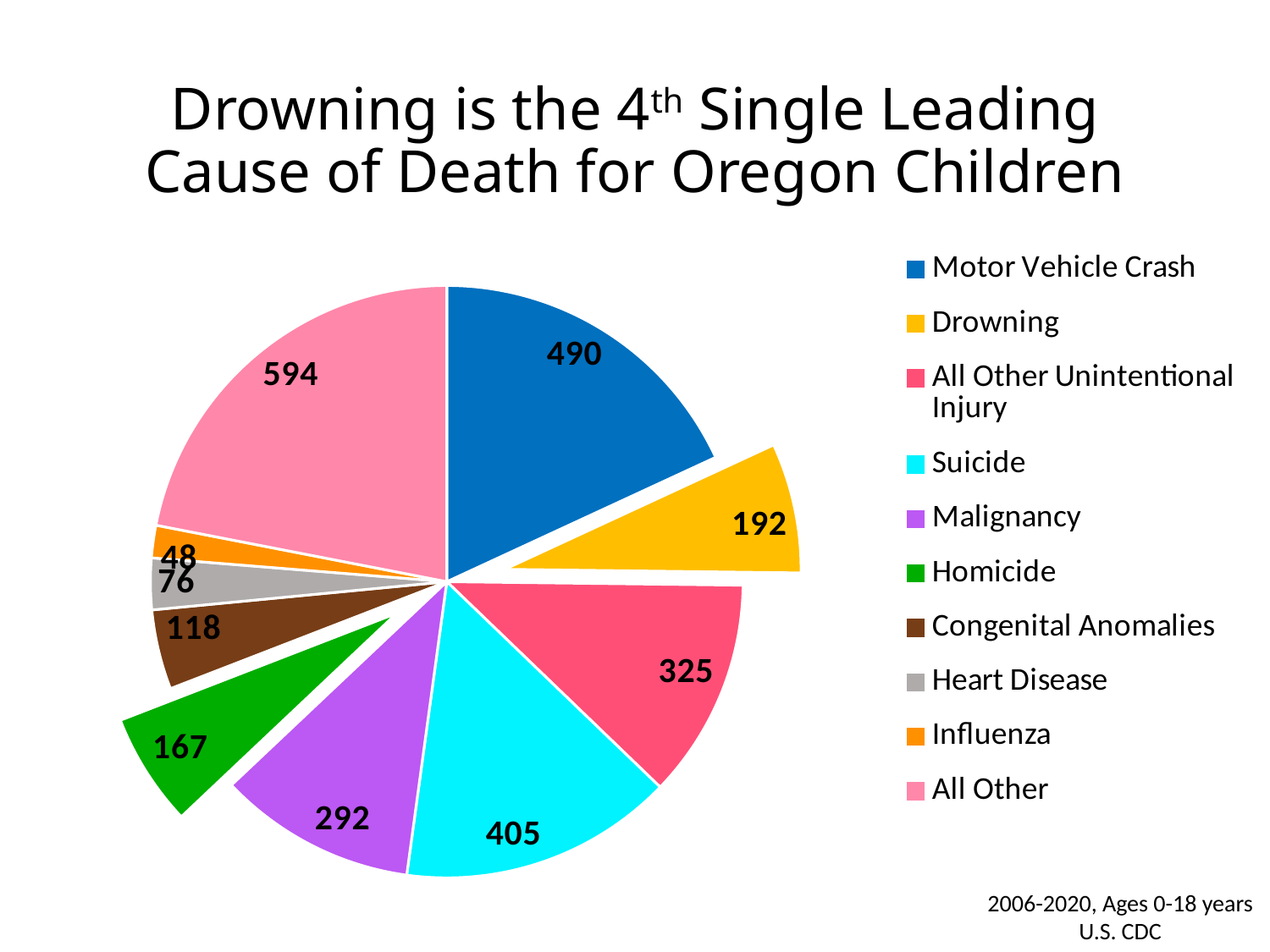
What value is shown for the Motor Vehicle Crash slice? 490 What kind of chart is shown on the slide? Pie chart What value is shown for the Heart Disease slice? 76 What value is shown for the Drowning slice? 192 What is the difference between the Motor Vehicle Crash value and the Drowning value? 298 What colour is the Drowning slice? Yellow Which category has the smallest slice of the pie? Influenza How many entries does the legend list? 10 What value is shown for the Suicide slice? 405 Which is larger, the Malignancy slice or the Homicide slice? Malignancy Which category has the largest slice of the pie? All Other How many slices does the pie chart have? 10